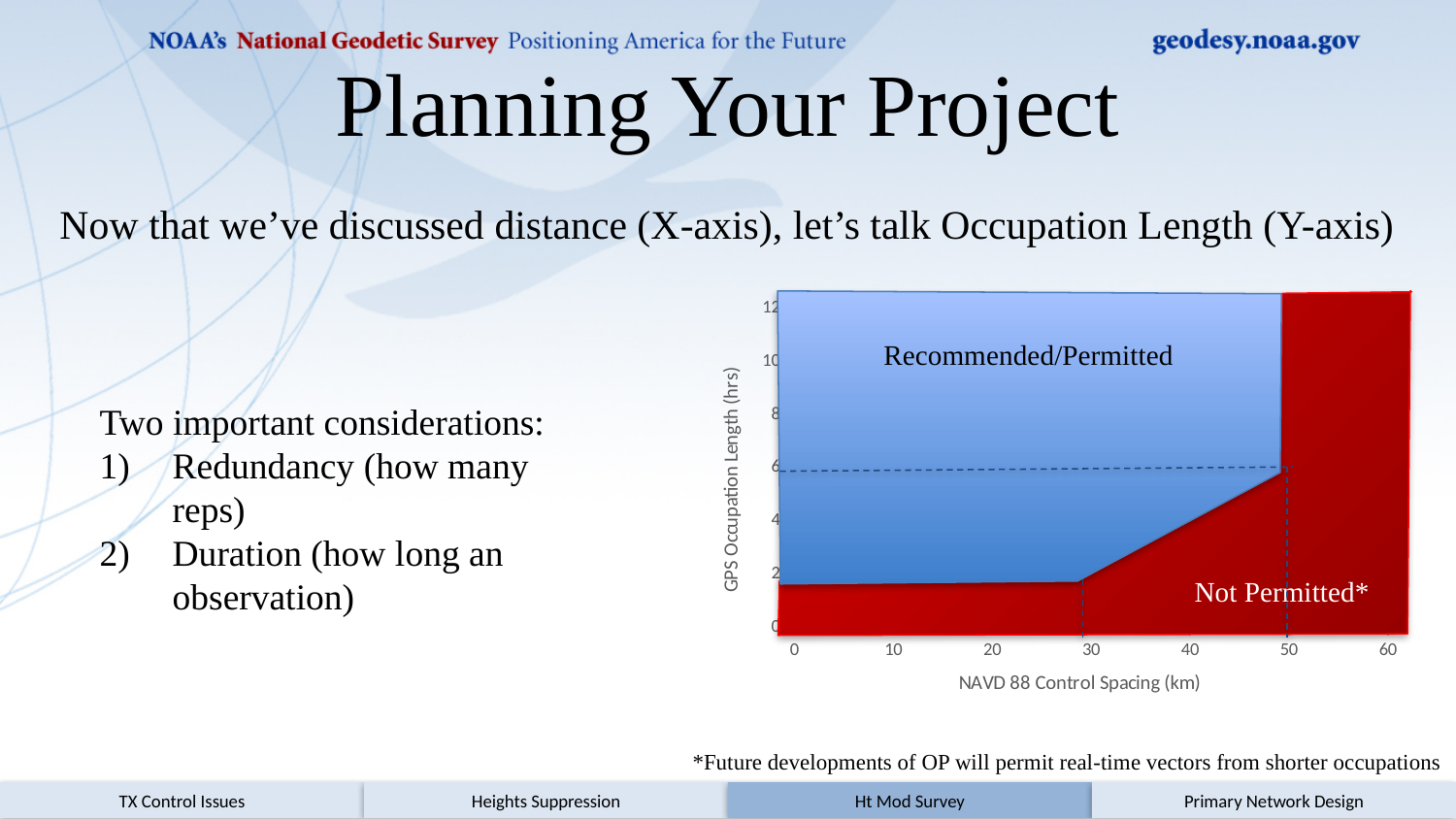
At a control spacing of 40 km, is the minimum permitted occupation length greater or less than 2 hours? greater At a control spacing of 40 km, is the minimum permitted occupation length greater or less than 6 hours? less What is the highest value shown on the y axis of the chart? 12 Does the boundary of the Recommended/Permitted region rise or fall as control spacing increases from 30 km to 50 km? rise Which region of the chart is coloured red? Not Permitted* Is a 10-hour occupation at a control spacing of 55 km in the Recommended/Permitted region or the Not Permitted region? Not Permitted What is the highest value shown on the x axis of the chart? 60 At a control spacing of 20 km, is the minimum permitted occupation length greater or less than 4 hours? less What is the label of the y axis of the chart? GPS Occupation Length (hrs) What is the label of the x axis of the chart? NAVD 88 Control Spacing (km) What kind of chart is shown on the slide? area chart How many labelled regions does the chart show? 2